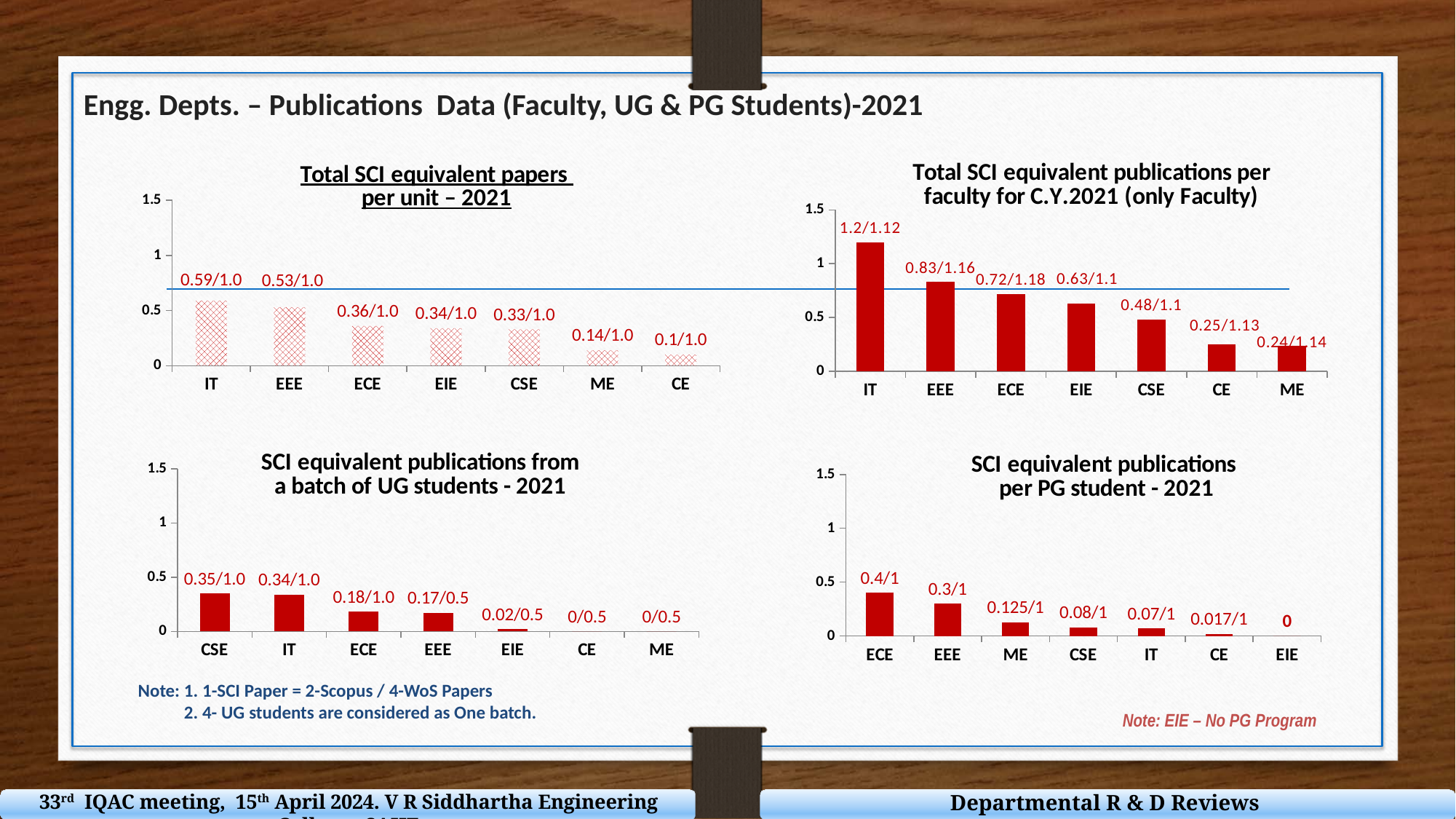
In the 'Total SCI equivalent publications per faculty for C.Y.2021 (only Faculty)' chart, is the value for IT greater or less than 1? greater In the 'SCI equivalent publications per PG student - 2021' chart, what is the data label shown for ME? 0.125/1 In the 'SCI equivalent publications per PG student - 2021' chart, what is the difference between the plotted values for ECE (0.4) and EEE (0.3)? 0.1 In the 'Total SCI equivalent publications per faculty for C.Y.2021 (only Faculty)' chart, which department has the highest value? IT In the 'Total SCI equivalent publications per faculty for C.Y.2021 (only Faculty)' chart, what is the data label shown for EEE? 0.83/1.16 What kind of chart is the 'Total SCI equivalent papers per unit – 2021' chart? bar chart In the 'SCI equivalent publications from a batch of UG students - 2021' chart, which department has the highest value? CSE In the 'Total SCI equivalent publications per faculty for C.Y.2021 (only Faculty)' chart, do the bar values rise or fall from left to right? fall In the 'Total SCI equivalent papers per unit – 2021' chart, what is the data label shown for IT? 0.59/1.0 How many departments are shown on the x axis of the 'SCI equivalent publications per PG student - 2021' chart? 7 In the 'Total SCI equivalent papers per unit – 2021' chart, what is the data label shown for CE? 0.1/1.0 In the 'SCI equivalent publications from a batch of UG students - 2021' chart, what is the data label shown for EEE? 0.17/0.5